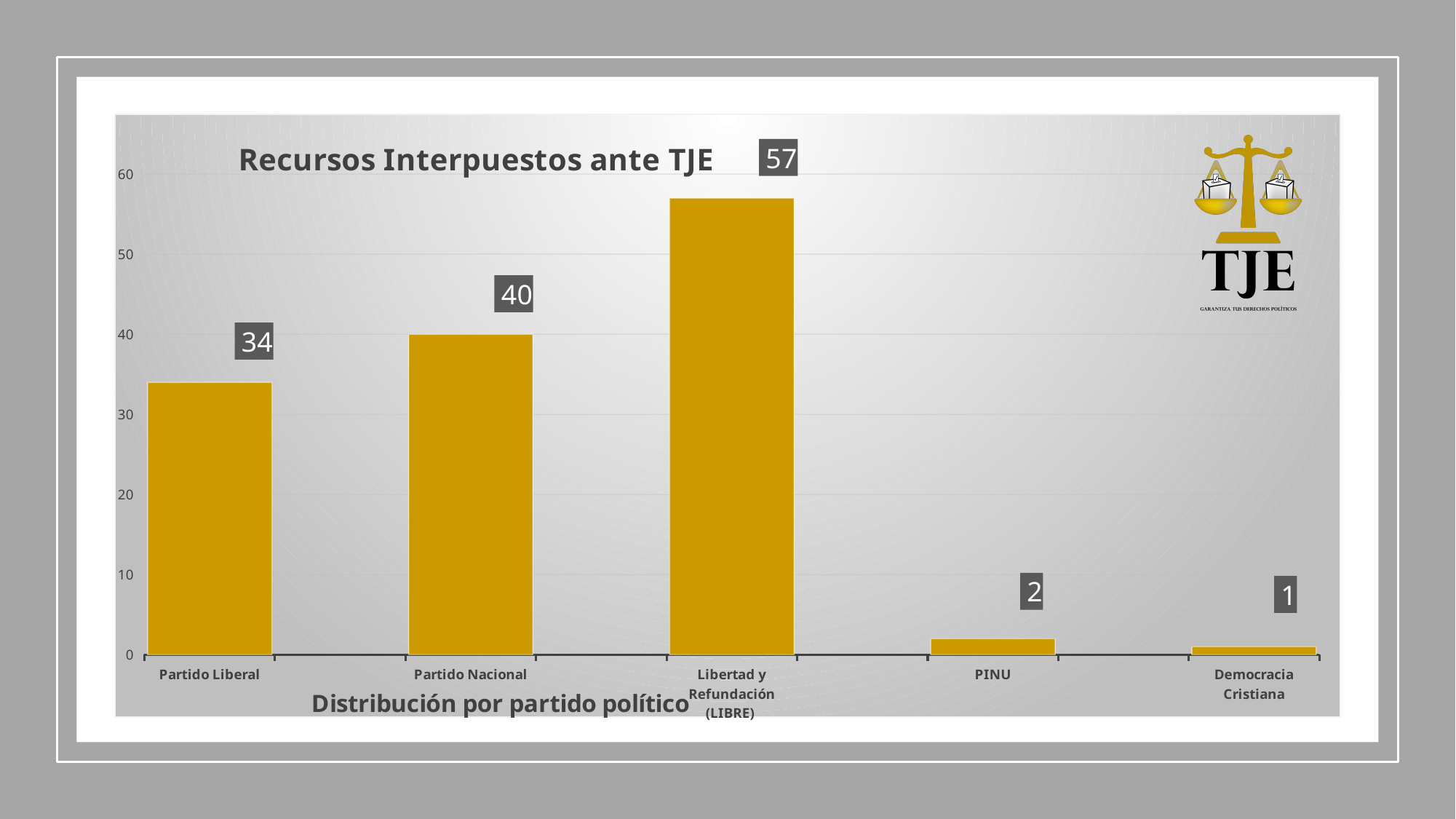
Which is larger, the value for Partido Liberal or the value for Partido Nacional? Partido Nacional Which party has the lowest value? Democracia Cristiana What is the difference between the values for Libertad y Refundación (LIBRE) and Partido Nacional? 17 What is the value for Partido Nacional? 40 What is the value for Libertad y Refundación (LIBRE)? 57 Is the value for Partido Liberal greater or less than 30? greater What kind of chart is shown? bar chart Which party has the highest value? Libertad y Refundación (LIBRE) What is the title of the chart? Recursos Interpuestos ante TJE What is the value for PINU? 2 What is the value for Partido Liberal? 34 How many parties are shown on the chart? 5